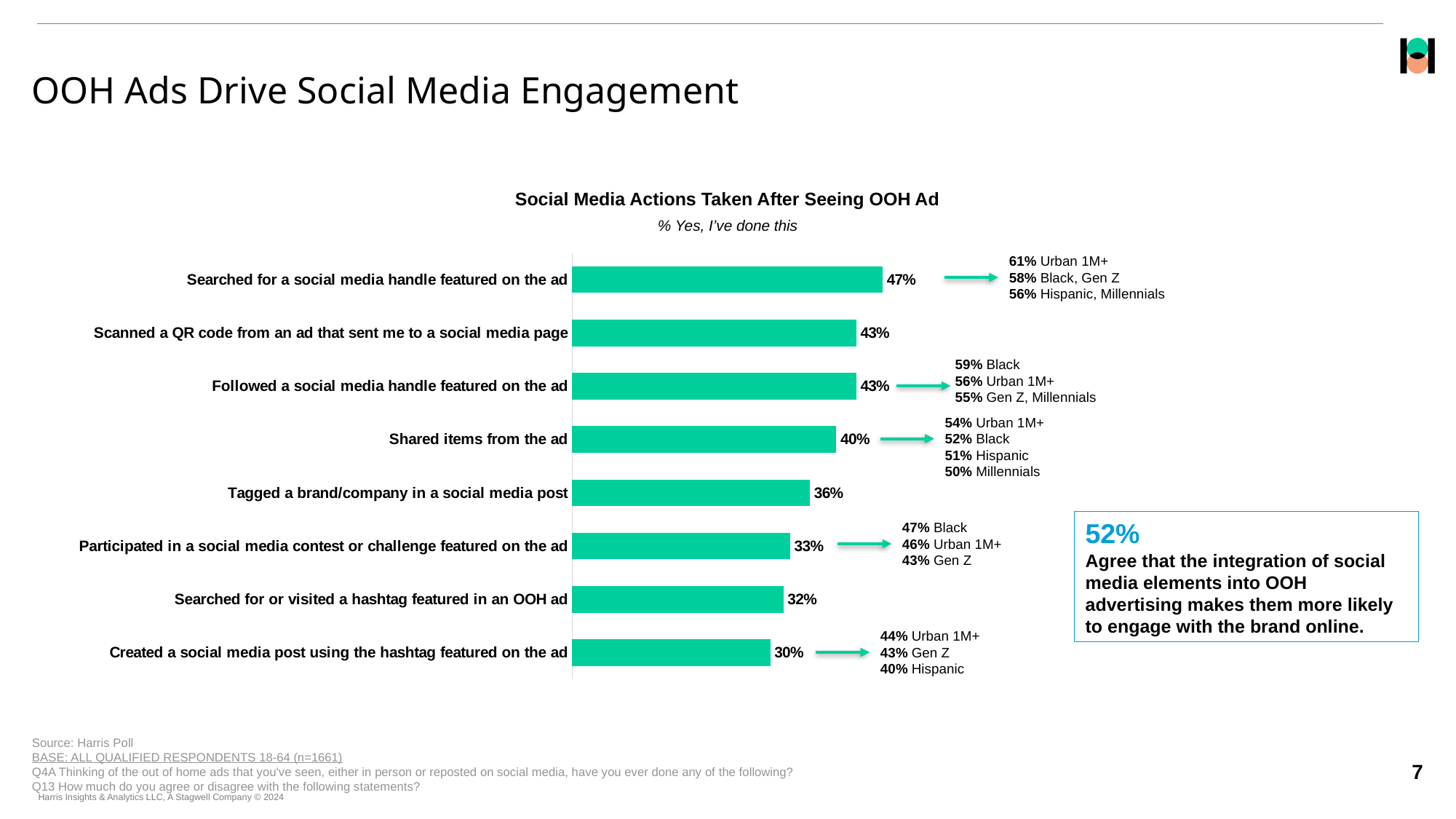
What percentage of respondents created a social media post using the hashtag featured on the ad? 30% What percentage of Urban 1M+ respondents searched for a social media handle featured on the ad? 61% What percentage of respondents searched for a social media handle featured on the ad? 47% What is the difference between 'Searched for a social media handle featured on the ad' and 'Tagged a brand/company in a social media post'? 11 percentage points How many social media actions are shown in the chart? 8 What type of chart is used to show the social media actions? Bar chart What is the title of the chart? Social Media Actions Taken After Seeing OOH Ad Which is larger: 'Shared items from the ad' or 'Participated in a social media contest or challenge featured on the ad'? Shared items from the ad Which social media action has the lowest percentage? Created a social media post using the hashtag featured on the ad Which social media action has the highest percentage? Searched for a social media handle featured on the ad What is the difference between 'Scanned a QR code from an ad that sent me to a social media page' and 'Searched for or visited a hashtag featured in an OOH ad'? 11 percentage points What is the value for 'Shared items from the ad'? 40%